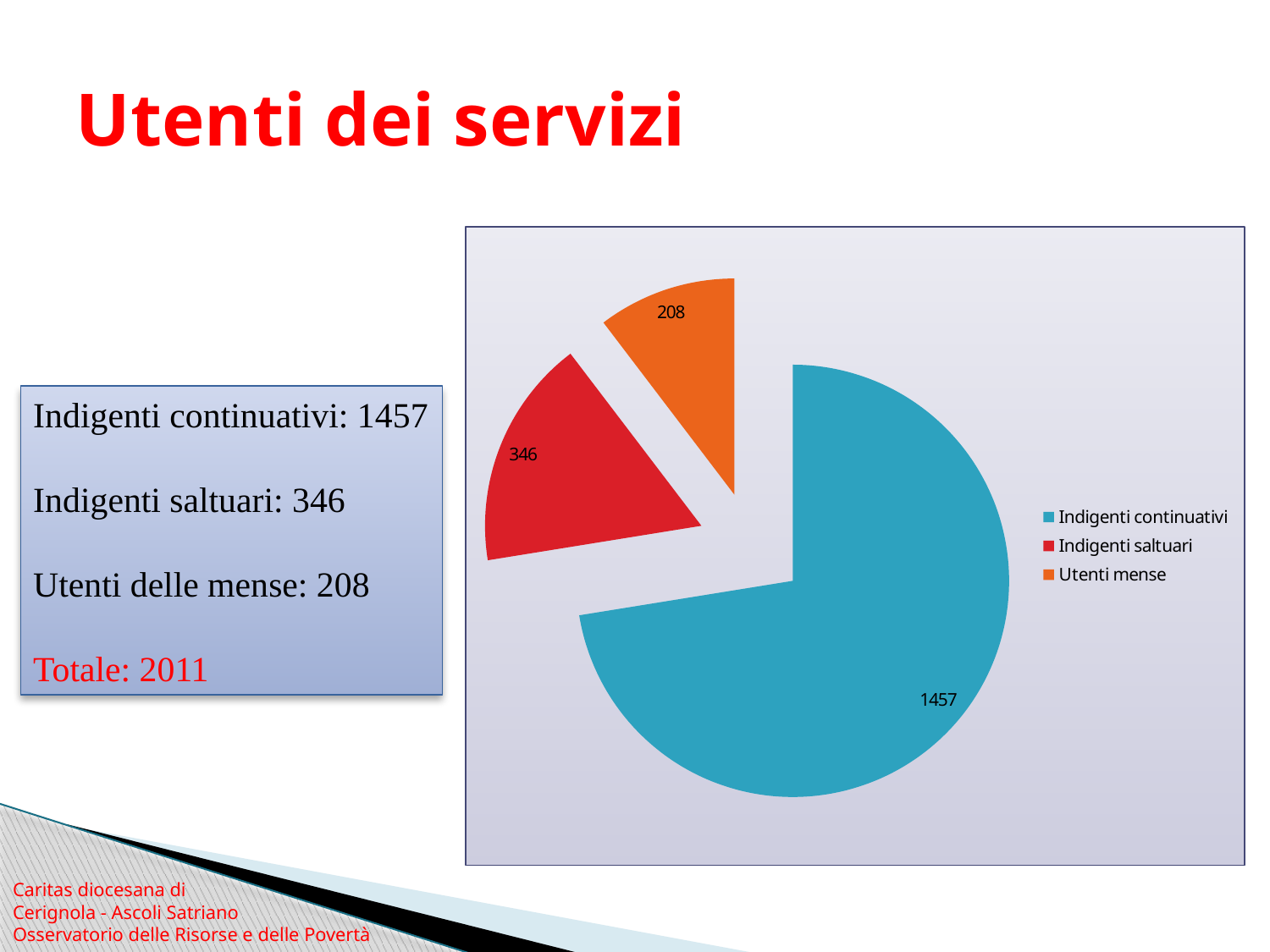
Which is larger, the value for Indigenti saltuari or the value for Utenti mense? Indigenti saltuari Which category has the smallest slice in the pie chart? Utenti mense What is the value for Utenti mense in the pie chart? 208 What colour is the Indigenti continuativi slice in the pie chart? Blue What type of chart is shown on the slide? Pie chart What is the value for Indigenti continuativi in the pie chart? 1457 How many slices does the pie chart have? 3 What is the difference between the values for Indigenti continuativi and Indigenti saltuari? 1111 What is the value for Indigenti saltuari in the pie chart? 346 What is the difference between the values for Indigenti saltuari and Utenti mense? 138 Which category has the largest slice in the pie chart? Indigenti continuativi What is the total of all the slices in the pie chart? 2011